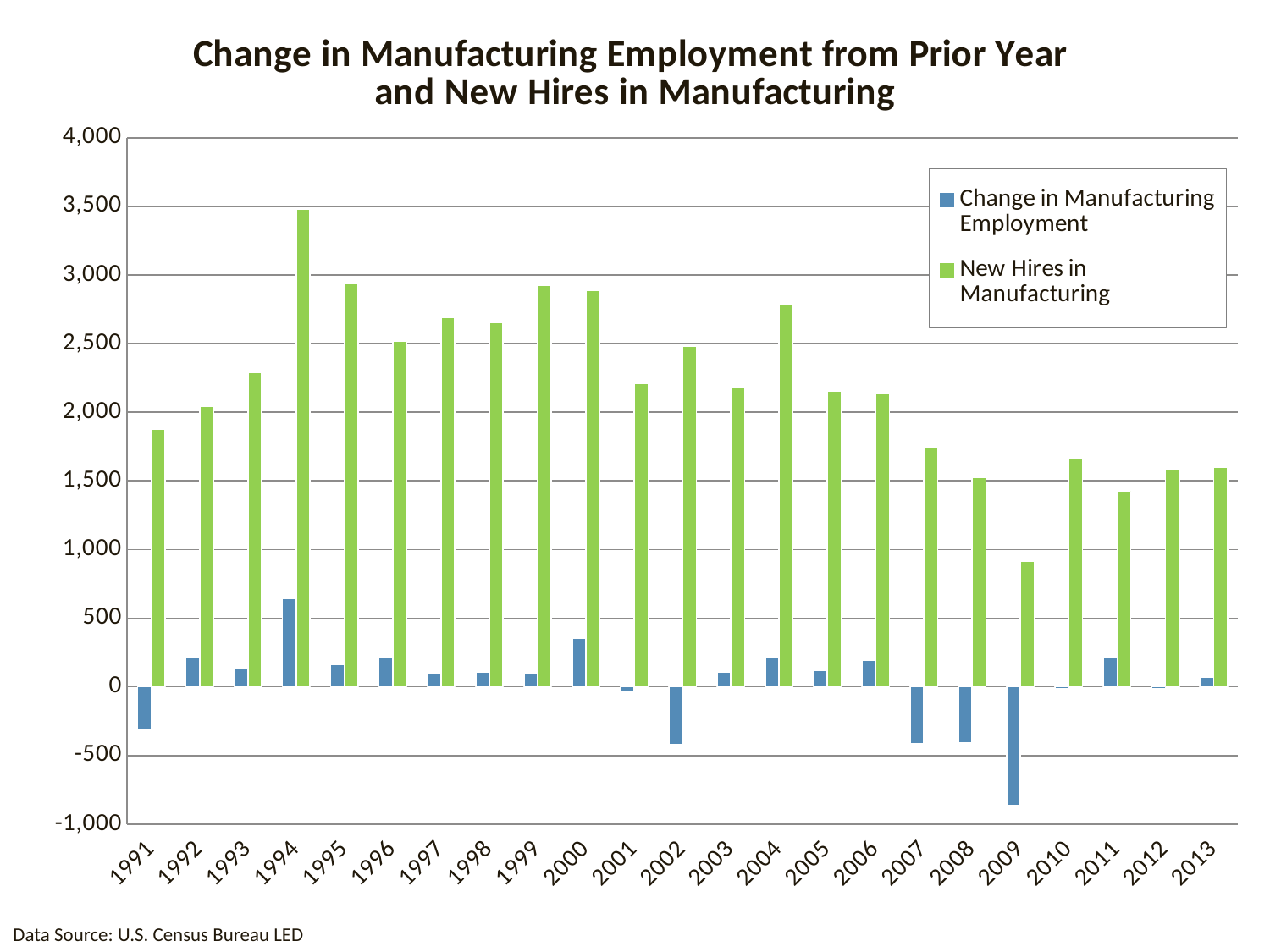
Which year has the larger value for New Hires in Manufacturing, 1999 or 2001? 1999 What kind of chart is shown on the slide? bar chart Is the value for New Hires in Manufacturing in 2009 greater or less than 1,000? less Is the value for New Hires in Manufacturing in 1994 greater or less than 3,000? greater Do the values for New Hires in Manufacturing rise or fall from 2004 to 2009? fall In which year is Change in Manufacturing Employment lowest? 2009 Is the value for Change in Manufacturing Employment in 2002 greater or less than 0? less In which year is Change in Manufacturing Employment highest? 1994 In which year is New Hires in Manufacturing highest? 1994 In which year is New Hires in Manufacturing lowest? 2009 How many years are shown on the x axis? 23 How many series does the legend list? 2